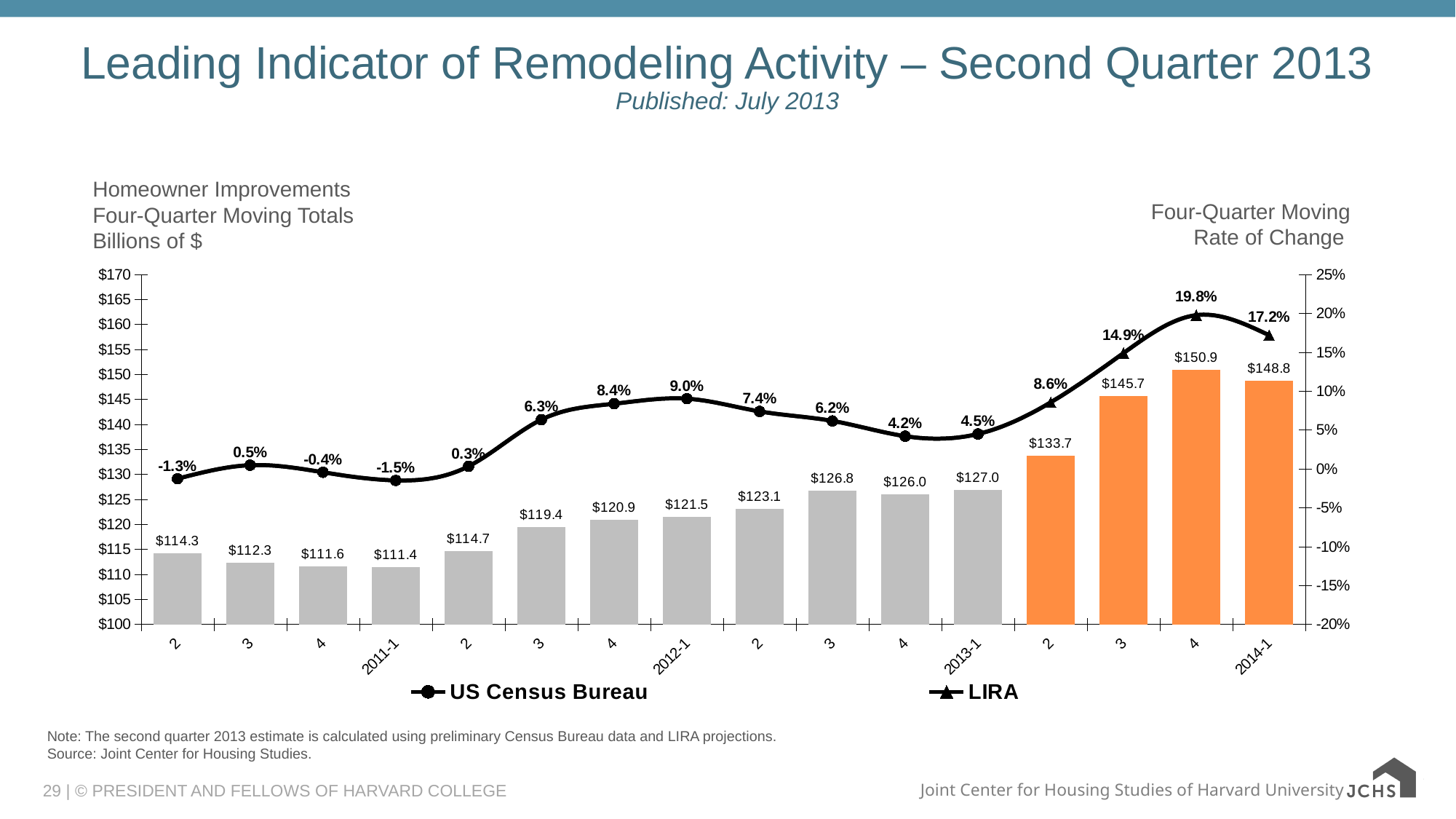
Which quarter has the highest four-quarter moving total bar? Fourth quarter of 2013 ($150.9) What is the lowest four-quarter moving rate of change shown on the line? -1.5% What is the difference between the four-quarter moving totals for 2013-1 and 2012-1? $5.5 How many quarters are plotted along the x axis? 16 Which is larger, the four-quarter moving total for 2014-1 or for the fourth quarter of 2013? Fourth quarter of 2013 ($150.9) How many series does the legend list? 2 Which quarter has the lowest four-quarter moving total bar? 2011-1 ($111.4) What is the four-quarter moving rate of change shown for 2014-1? 17.2% What kind of chart is this? Combination bar and line chart What is the four-quarter moving total for 2012-1? $121.5 What is the four-quarter moving total for 2013-1? $127.0 What is the highest four-quarter moving rate of change shown on the line? 19.8%